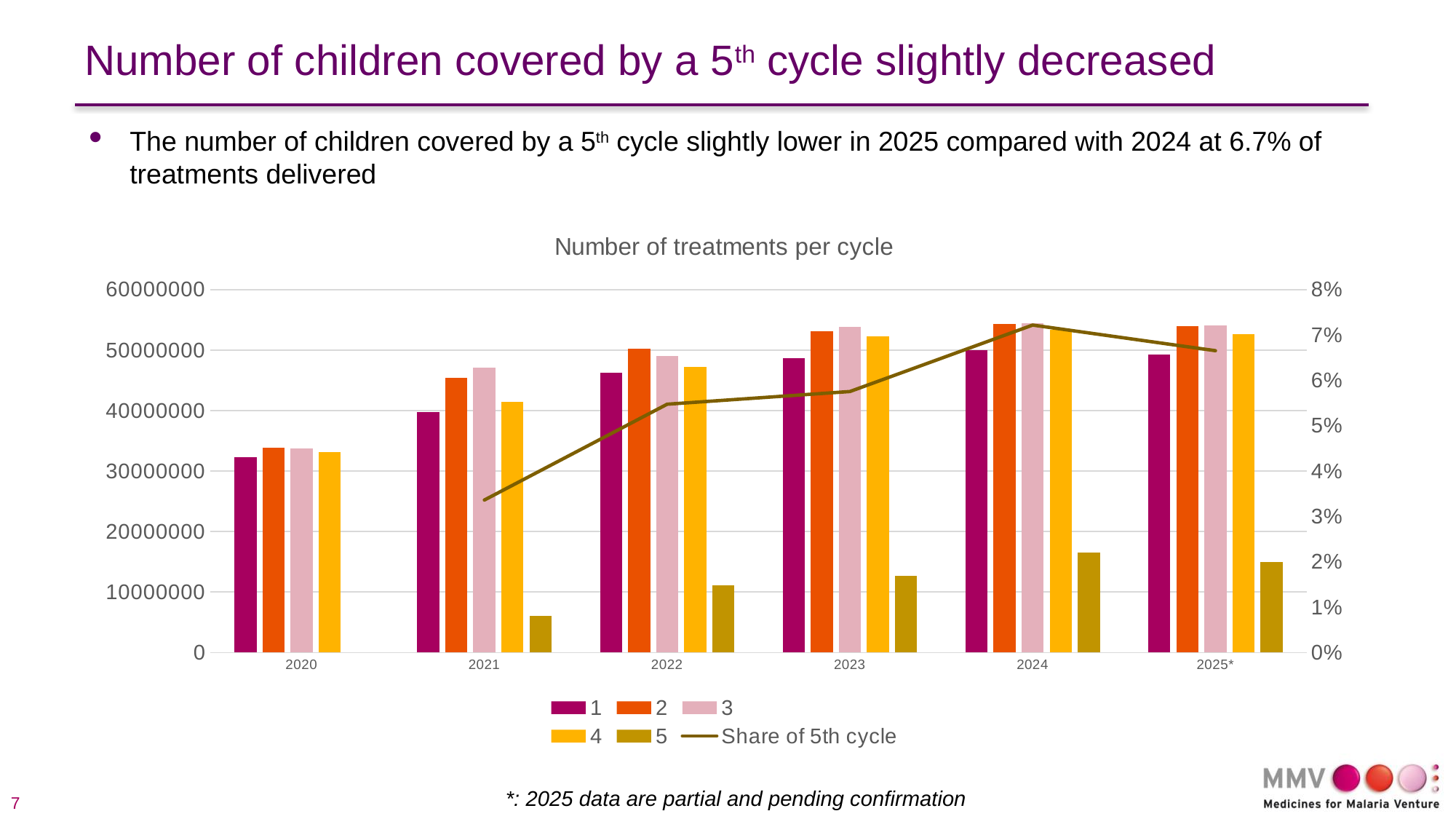
In which year is the cycle 5 bar the highest? 2024 Is the Share of 5th cycle in 2021 greater or less than 4%? less In which year is the cycle 1 bar the lowest? 2020 Is the value for cycle 5 in 2024 greater or less than 10000000? greater Which is larger, the cycle 5 value in 2024 or in 2025*? 2024 Is the value for cycle 5 in 2021 greater or less than 10000000? less Does the Share of 5th cycle line rise or fall from 2021 to 2024? rise What kind of chart is shown on the slide? bar chart with a line series What is the title of the chart? Number of treatments per cycle How many years are shown on the x axis? 6 How many series does the legend list? 6